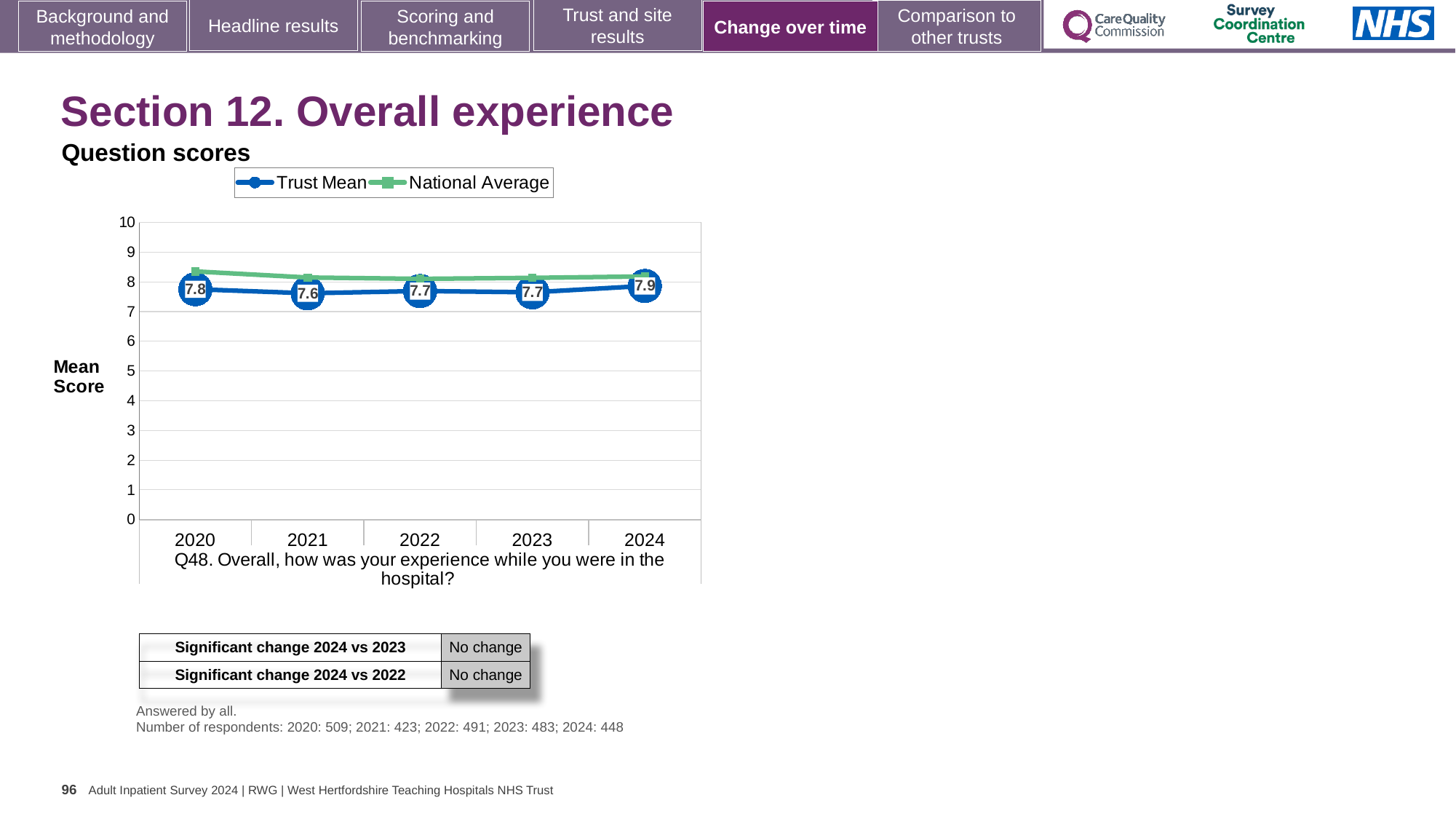
In which year is the Trust Mean score lowest? 2021 What is the difference between the Trust Mean scores for 2024 and 2021? 0.3 How many years are shown on the x axis? 5 Does the Trust Mean score rise or fall from 2023 to 2024? Rise What kind of chart is shown? Line chart Is the National Average value for 2020 greater or less than 8? greater Which is larger, the Trust Mean score for 2020 or for 2021? 2020 What is the Trust Mean score for 2020? 7.8 What is the Trust Mean score for 2021? 7.6 What is the Trust Mean score for 2024? 7.9 How many series does the legend list? 2 In which year is the Trust Mean score highest? 2024